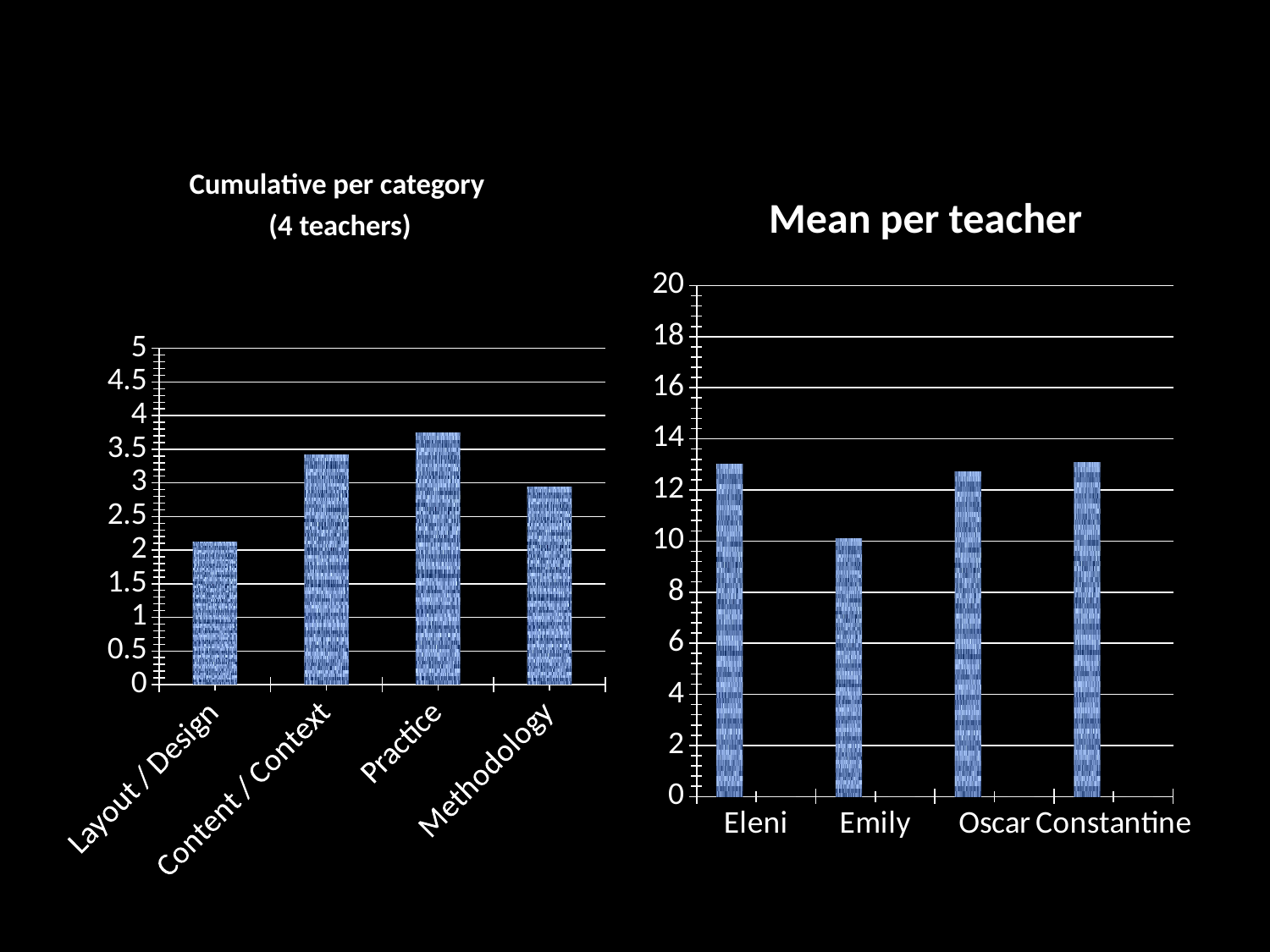
How many teachers are shown on the 'Mean per teacher' chart? 4 On the 'Cumulative per category (4 teachers)' chart, which category has the highest value? Practice On the 'Cumulative per category (4 teachers)' chart, is the value for Content / Context greater or less than 3? greater On the 'Cumulative per category (4 teachers)' chart, is the value for Practice greater or less than 3.5? greater On the 'Mean per teacher' chart, is the value for Emily greater or less than 12? less What kind of chart is the 'Mean per teacher' chart? Bar chart On the 'Mean per teacher' chart, which is larger, the value for Eleni or the value for Emily? Eleni On the 'Cumulative per category (4 teachers)' chart, which is larger, the value for Methodology or the value for Layout / Design? Methodology On the 'Cumulative per category (4 teachers)' chart, which category has the lowest value? Layout / Design On the 'Mean per teacher' chart, which teacher has the lowest mean? Emily